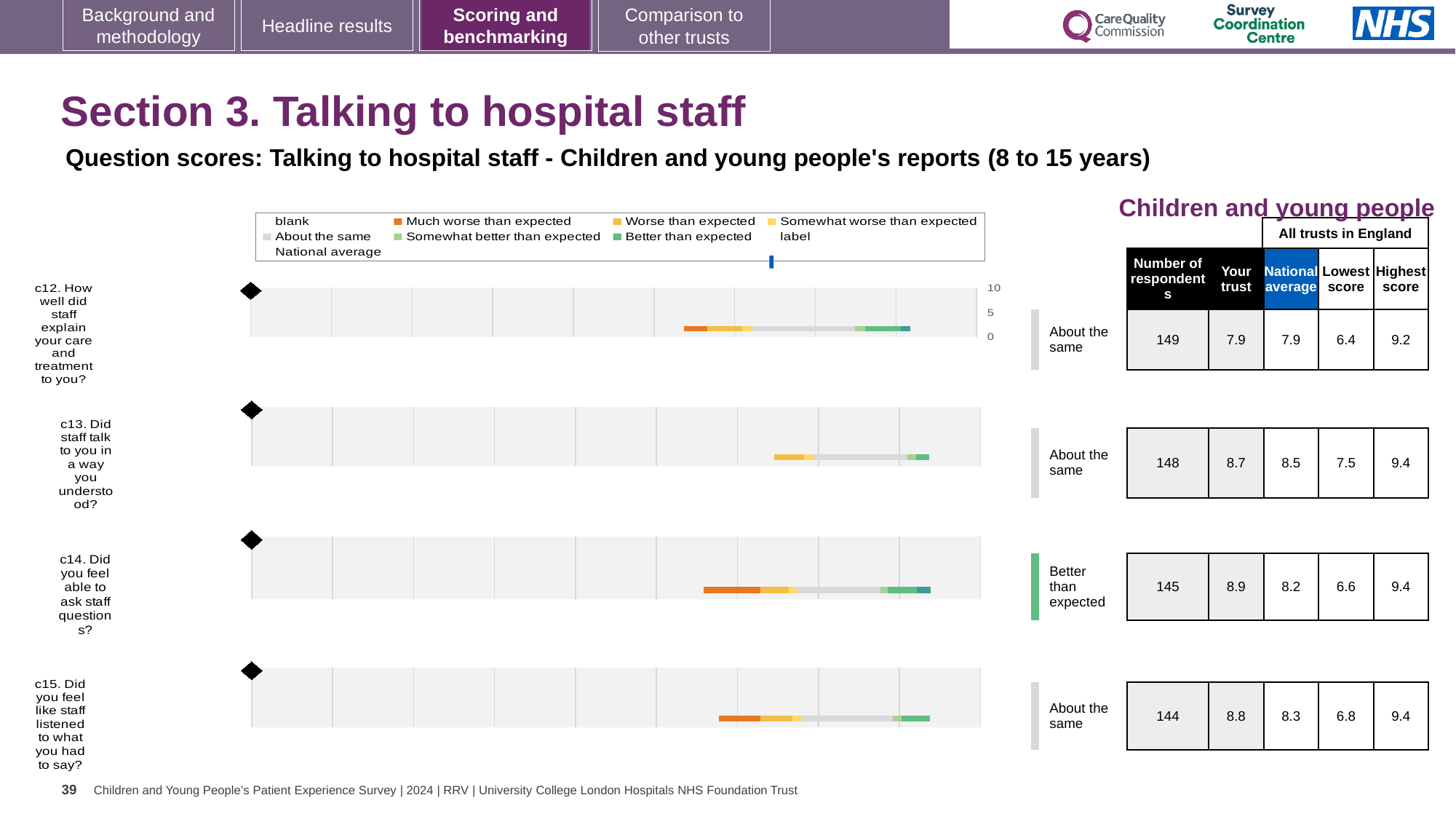
How many question charts are shown on the slide? 4 For the c12 chart 'How well did staff explain your care and treatment to you?', what is the national average score? 7.9 Which question has the highest 'Your trust' score? c14. Did you feel able to ask staff questions? For the c14 chart 'Did you feel able to ask staff questions?', what is the 'Your trust' score? 8.9 For the c13 chart 'Did staff talk to you in a way you understood?', what is the highest score among all trusts in England? 9.4 For the c14 chart, what is the difference between the 'Your trust' score and the national average? 0.7 What kind of chart is used for question c12 'How well did staff explain your care and treatment to you?'? bar chart What benchmark category is shown next to the c14 chart 'Did you feel able to ask staff questions?'? Better than expected For the c15 chart 'Did you feel like staff listened to what you had to say?', how many respondents are there? 144 For the c13 chart 'Did staff talk to you in a way you understood?', which is larger: the 'Your trust' score or the national average? Your trust In the legend, what colour represents 'Much worse than expected'? orange Which question has the lowest 'Your trust' score? c12. How well did staff explain your care and treatment to you?